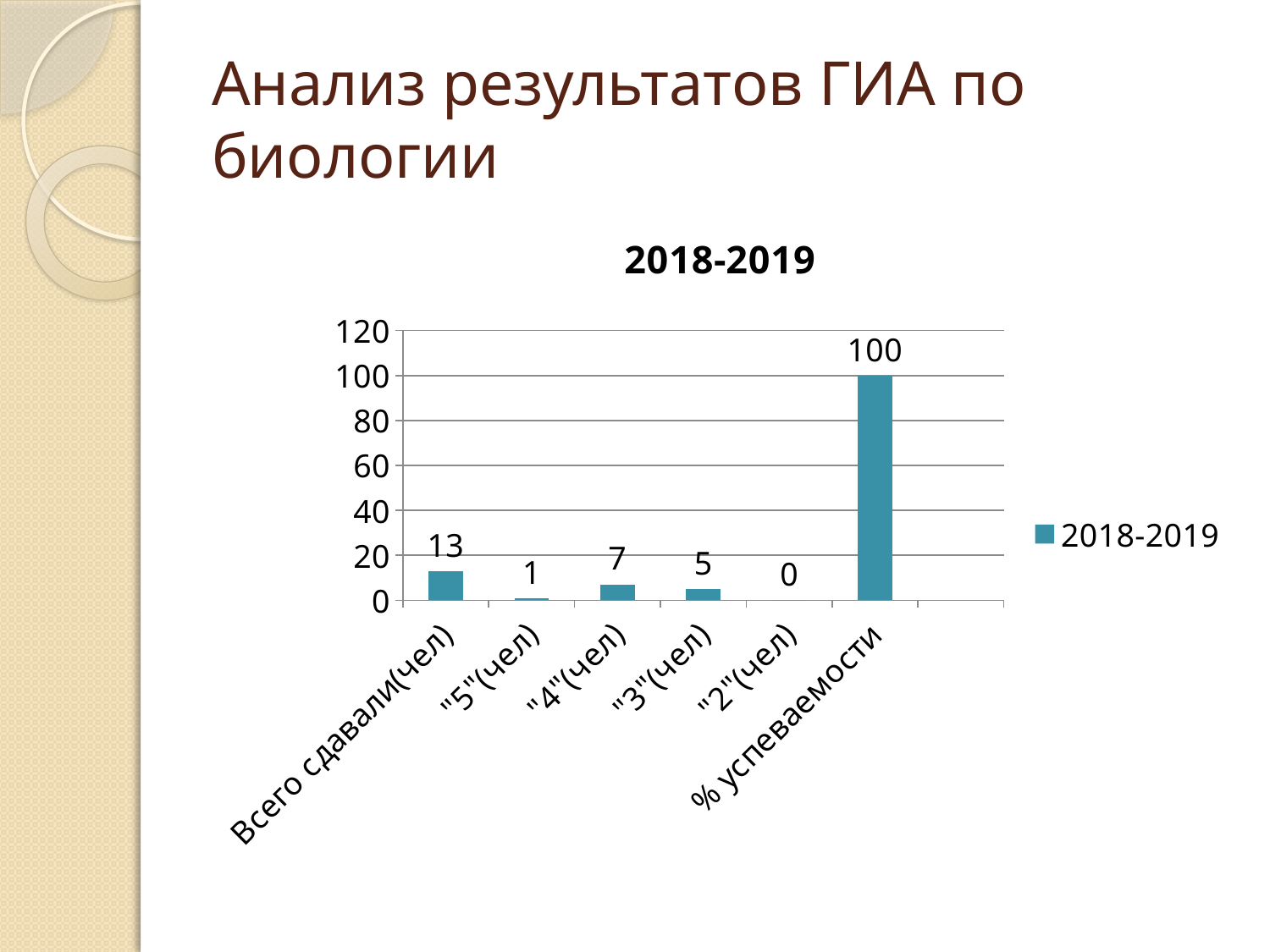
Which is larger, the value for "5"(чел) or the value for "4"(чел)? "4"(чел) Which category has the lowest value? "2"(чел) What is the value for "4"(чел)? 7 What kind of chart is shown on the slide? bar chart Is the value for % успеваемости greater or less than 80? greater How many series does the legend list? 1 What is the value for "Всего сдавали(чел)"? 13 What is the difference between the values for "4"(чел) and "3"(чел)? 2 What is the value for "2"(чел)? 0 Which category has the highest value? % успеваемости What is the value for "3"(чел)? 5 How many categories are shown on the x axis? 6